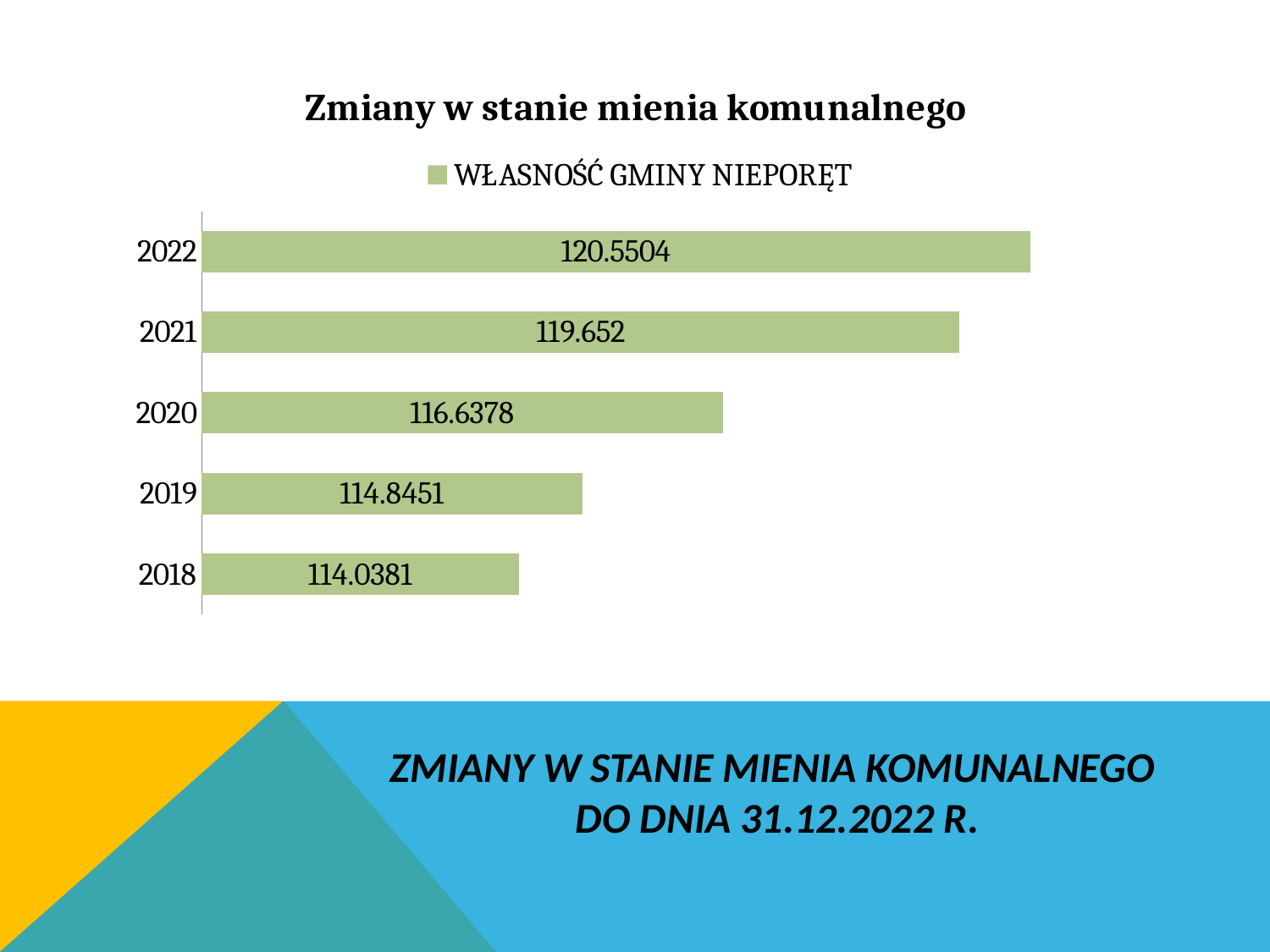
How many series does the legend list? 1 What is the value for 2018? 114.0381 What is the value for 2020? 116.6378 What kind of chart is shown? bar chart Which is larger, the value for 2020 or the value for 2019? 2020 What is the difference between the values for 2022 and 2021? 0.8984 Which year has the highest value? 2022 What is the difference between the values for 2022 and 2018? 6.5123 What is the value for 2022? 120.5504 Do the values rise or fall from 2018 to 2022? rise Which year has the lowest value? 2018 How many years are shown in the chart? 5